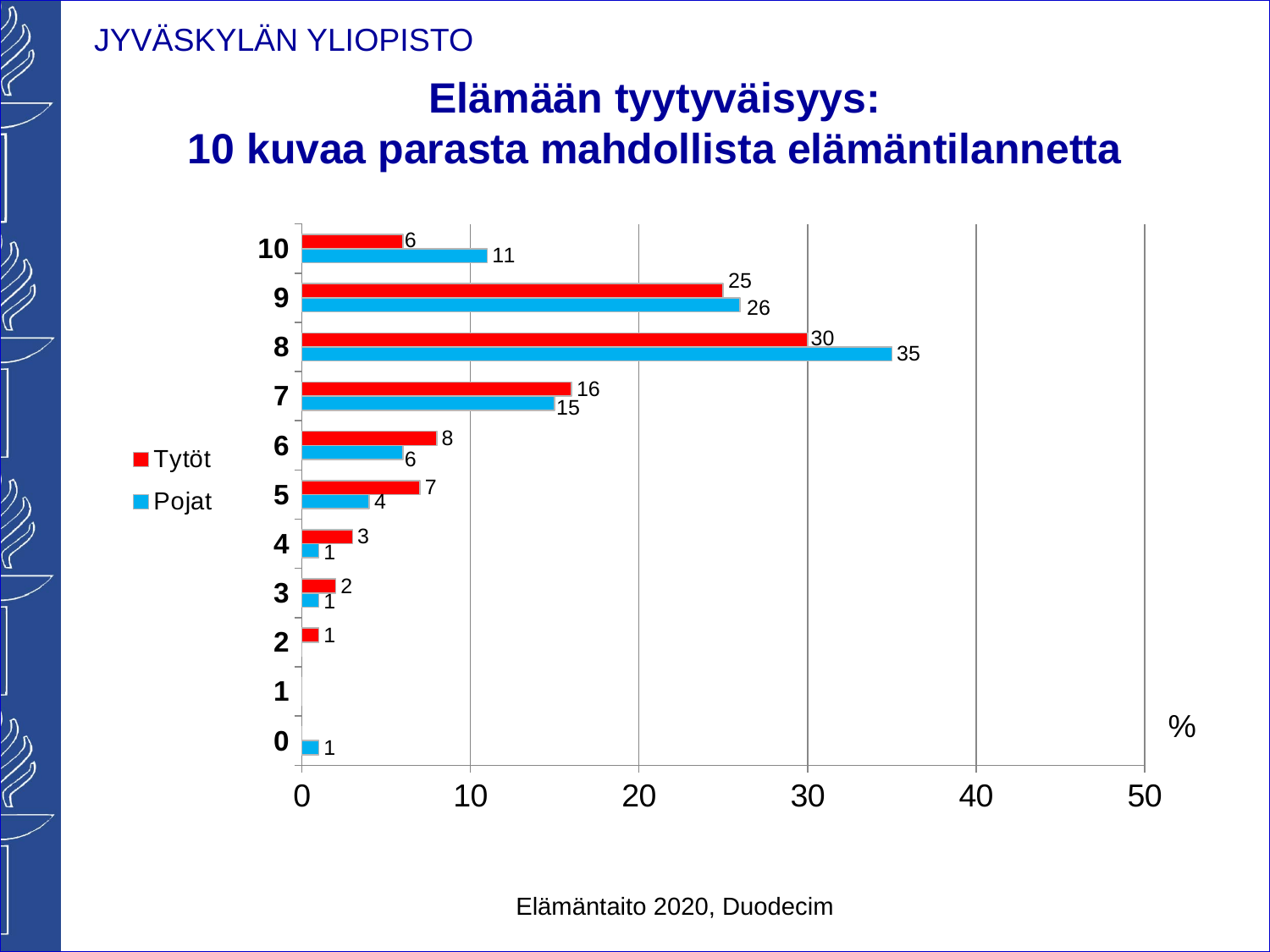
What is the Tytöt value for category 9? 25 What is the difference between the Pojat and Tytöt values for category 8? 5 Which colour represents the Pojat series? Blue Which category has the highest Tytöt value? 8 For category 10, which series has the larger value, Tytöt or Pojat? Pojat What is the difference between the Tytöt values for category 8 and category 9? 5 How many series does the legend list? 2 For category 7, which series has the larger value, Tytöt or Pojat? Tytöt How many categories are shown on the vertical axis? 11 What is the Pojat value for category 10? 11 What kind of chart is shown on the slide? Bar chart What is the Pojat value for category 8? 35